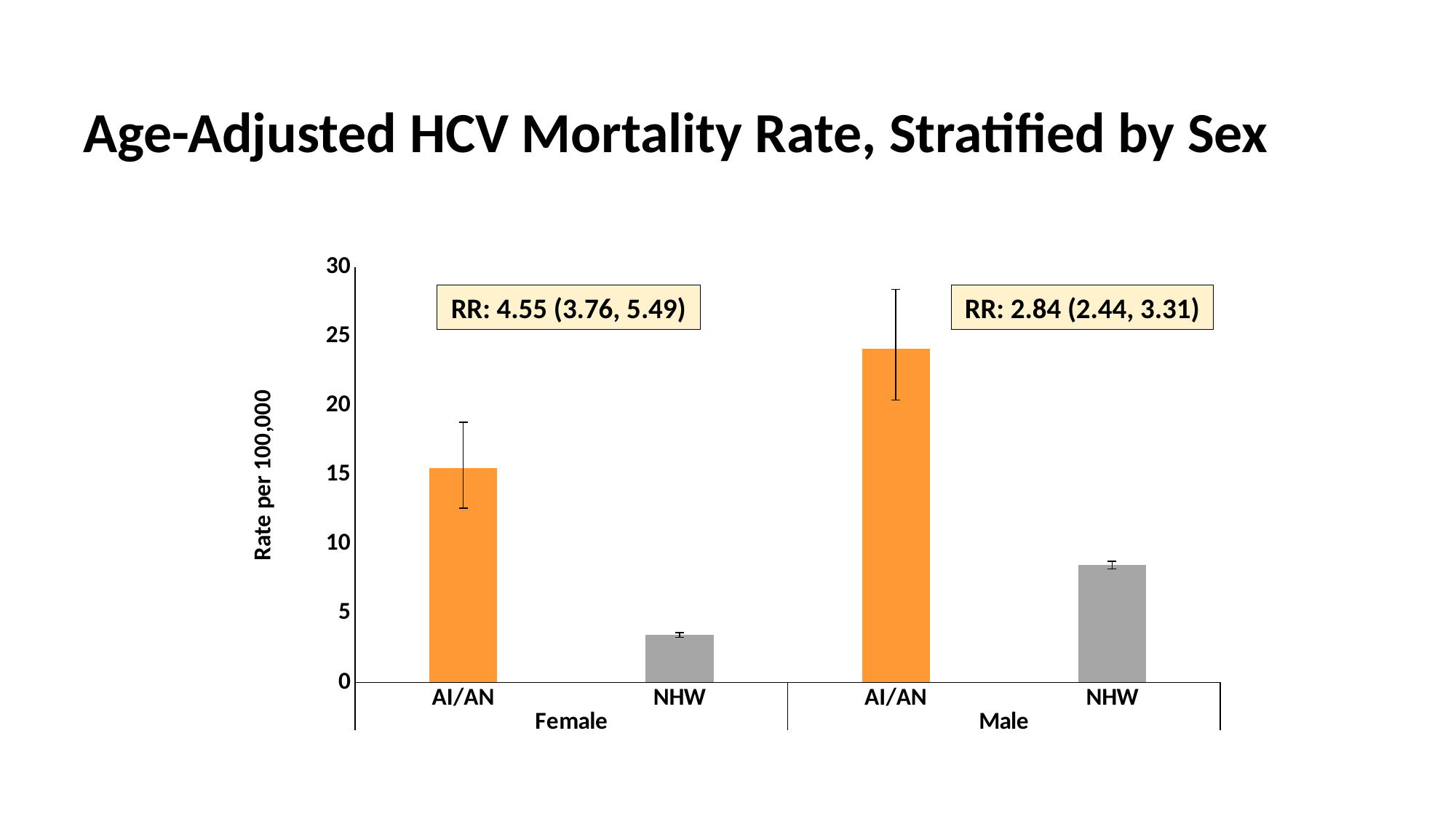
How many bars are plotted in the chart? 4 What is the label of the vertical axis? Rate per 100,000 What is the title of the chart? Age-Adjusted HCV Mortality Rate, Stratified by Sex Is the value for Male NHW greater or less than 10? less What relative risk (RR) is shown in the annotation box for the Female group? RR: 4.55 (3.76, 5.49) Which bar is the lowest in the chart? Female NHW What kind of chart is shown on the slide? bar chart Is the value for Female AI/AN greater or less than 10? greater Is the value for Male AI/AN greater or less than 20? greater Which bar is the highest in the chart? Male AI/AN Which is larger, the value for Male NHW or the value for Female NHW? Male NHW